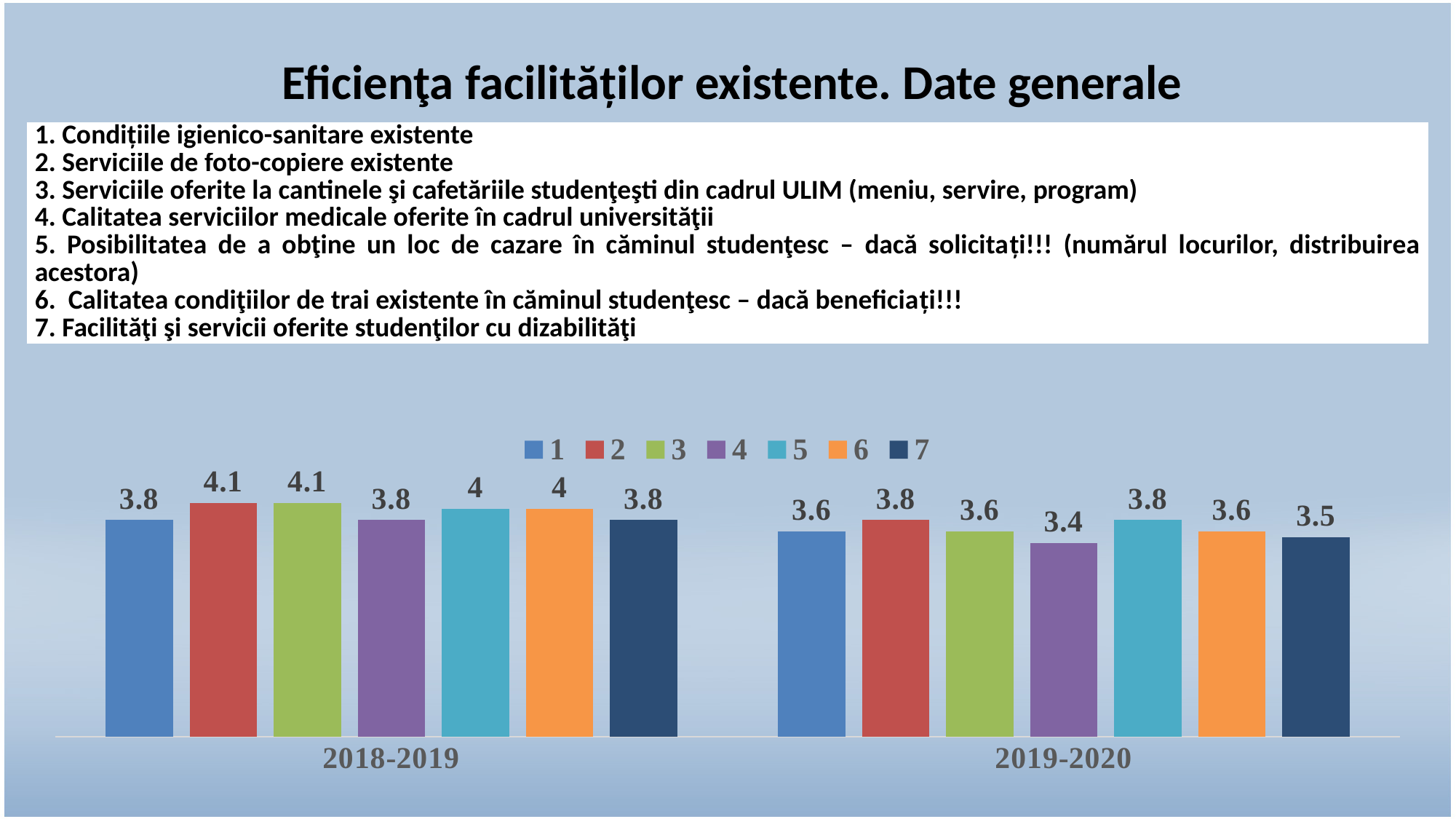
Which series has the lowest value in 2019-2020? 4 What is the value for series 7 in 2019-2020? 3.5 What is the value for series 4 in 2019-2020? 3.4 What is the value for series 2 in 2018-2019? 4.1 Does the value for series 1 rise or fall from 2018-2019 to 2019-2020? fall What kind of chart is shown on the slide? bar chart Which is larger: series 3 in 2018-2019 or series 3 in 2019-2020? 2018-2019 What is the difference between the value for series 2 in 2018-2019 and in 2019-2020? 0.3 How many categories are shown on the x axis? 2 What is the value for series 5 in 2018-2019? 4 How many series does the legend list? 7 What is the difference between series 5 and series 4 in 2019-2020? 0.4